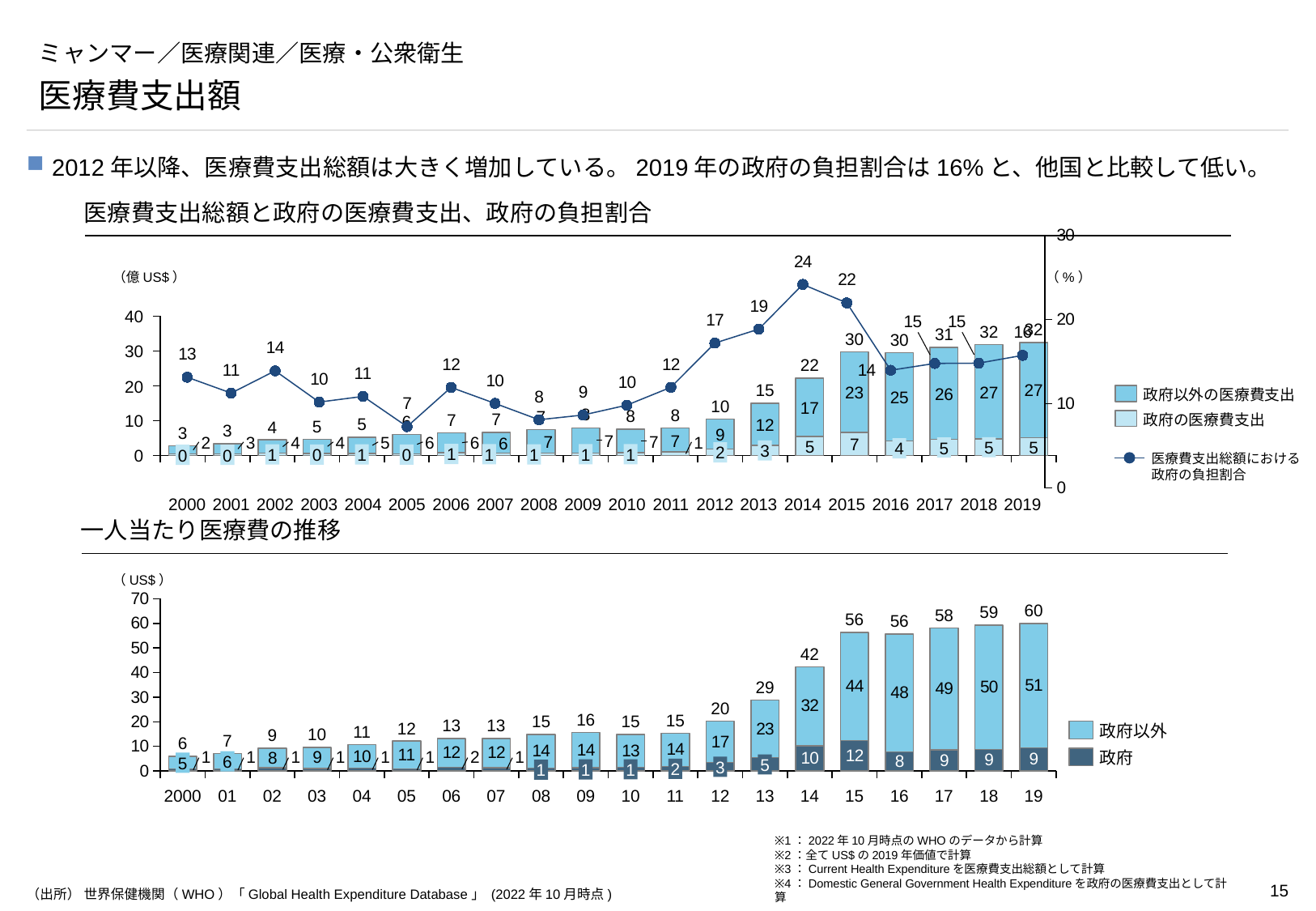
In the bottom chart, which year has the highest total per-capita expenditure? 19 In the top chart, what is the total of the stacked bar for 2018? 32 In the bottom chart, how many years are shown on the x axis? 20 In the top chart, how many series does the legend list? 3 In the top chart, which year has the highest 政府の負担割合 on the line? 2014 In the bottom chart (一人当たり医療費の推移), what is the 政府以外 value for 2016? 48 In the top chart, what is the 政府以外の医療費支出 value for 2019? 27 In the top chart, what is the difference between the 政府の負担割合 values for 2013 and 2019? 3 In the top chart (医療費支出総額と政府の医療費支出、政府の負担割合), what is the 政府の負担割合 value for 2014? 24 In the bottom chart, what is the 政府 value for 2015? 12 In the bottom chart, is the total for 2014 larger or smaller than the total for 2013? larger In the top chart, what is the 政府の医療費支出 value for 2015? 7